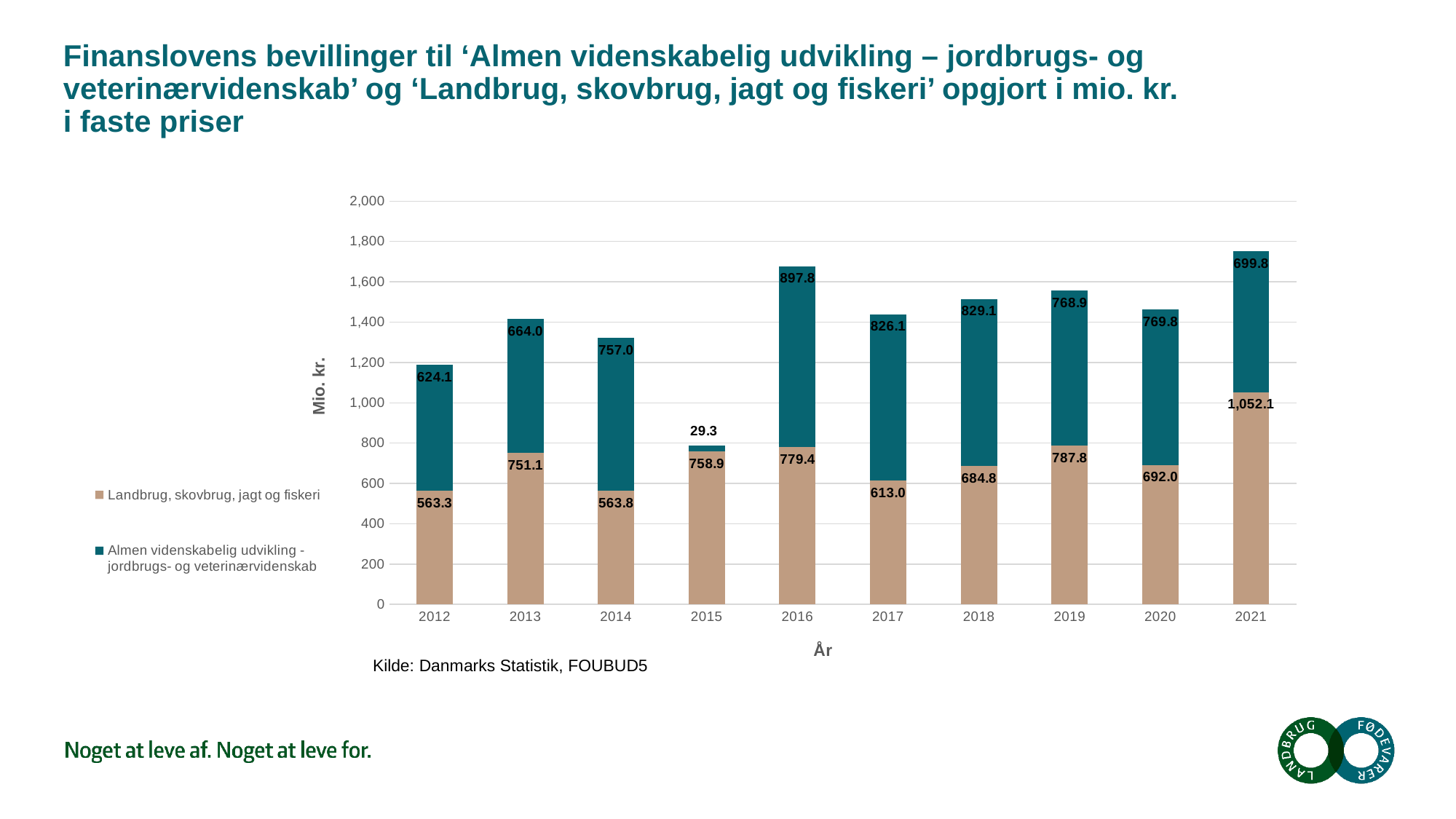
In which year is the 'Landbrug, skovbrug, jagt og fiskeri' value highest? 2021 Which is larger in 2019: 'Landbrug, skovbrug, jagt og fiskeri' or 'Almen videnskabelig udvikling - jordbrugs- og veterinærvidenskab'? Landbrug, skovbrug, jagt og fiskeri In which year is the 'Almen videnskabelig udvikling - jordbrugs- og veterinærvidenskab' value lowest? 2015 What is the difference between the 'Landbrug, skovbrug, jagt og fiskeri' values for 2013 and 2012? 187.8 What is the total of the stacked bar for 2021? 1,751.9 What is the value for 'Almen videnskabelig udvikling - jordbrugs- og veterinærvidenskab' in 2016? 897.8 What is the value for 'Landbrug, skovbrug, jagt og fiskeri' in 2021? 1,052.1 How many series does the legend list? 2 How many years are shown on the x axis? 10 What is the total of the stacked bar for 2015? 788.2 What is the value for 'Almen videnskabelig udvikling - jordbrugs- og veterinærvidenskab' in 2015? 29.3 What kind of chart is shown on the slide? Stacked bar chart